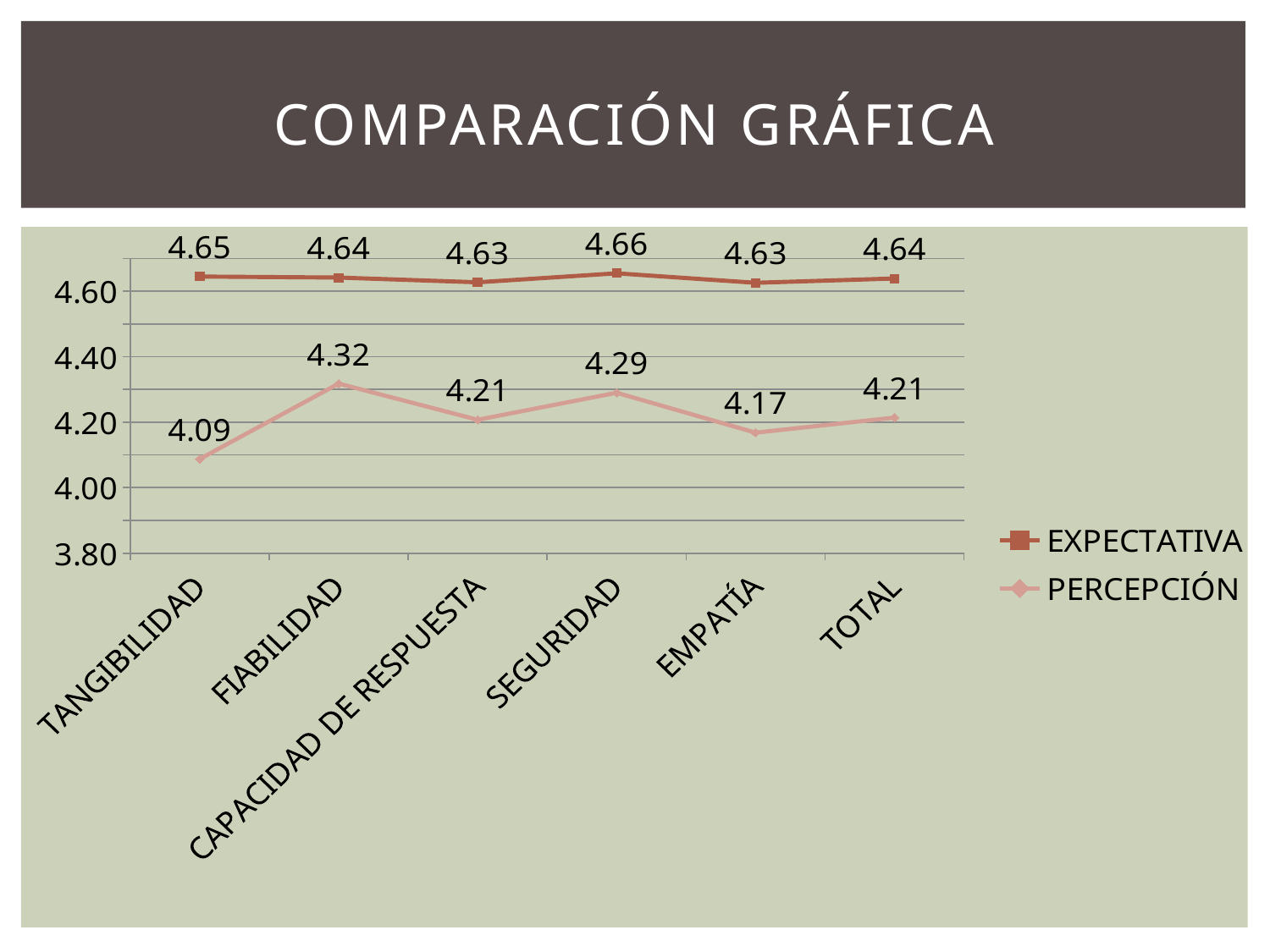
Which is larger for EMPATÍA, the EXPECTATIVA value or the PERCEPCIÓN value? EXPECTATIVA What is the EXPECTATIVA value for TOTAL? 4.64 Which category has the highest PERCEPCIÓN value? FIABILIDAD What is the PERCEPCIÓN value for TANGIBILIDAD? 4.09 How many series does the legend list? 2 What is the difference between EXPECTATIVA and PERCEPCIÓN for TOTAL? 0.43 How many categories are shown on the x axis? 6 What kind of chart is shown on the slide? Line chart What is the EXPECTATIVA value for SEGURIDAD? 4.66 What is the PERCEPCIÓN value for FIABILIDAD? 4.32 What is the difference between EXPECTATIVA and PERCEPCIÓN for TANGIBILIDAD? 0.56 Which category has the lowest PERCEPCIÓN value? TANGIBILIDAD